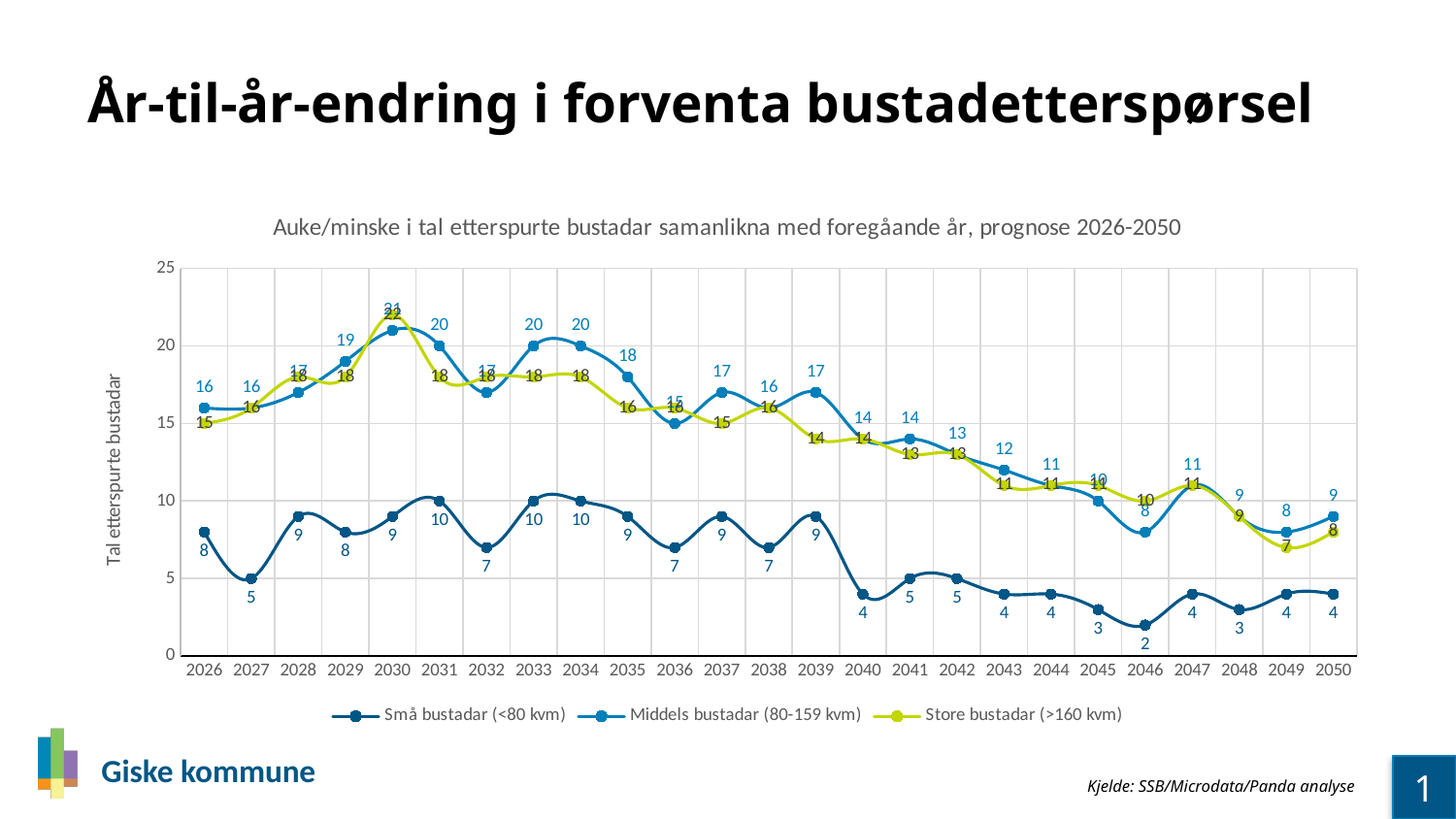
What is the value for Store bustadar (>160 kvm) in 2049? 7 In 2037, which is larger: Middels bustadar (80-159 kvm) or Store bustadar (>160 kvm)? Middels bustadar (80-159 kvm) What is the value for Middels bustadar (80-159 kvm) in 2033? 20 What is the label on the vertical axis? Tal etterspurte bustadar What is the difference between the Små bustadar (<80 kvm) values for 2026 and 2027? 3 How many years are plotted along the x axis? 25 Is the value for Middels bustadar (80-159 kvm) in 2029 greater or less than 15? greater What kind of chart is shown on the slide? line chart What is the value for Små bustadar (<80 kvm) in 2027? 5 In which year is the value for Små bustadar (<80 kvm) lowest? 2046 How many series does the legend list? 3 In which year is the value for Middels bustadar (80-159 kvm) highest? 2030